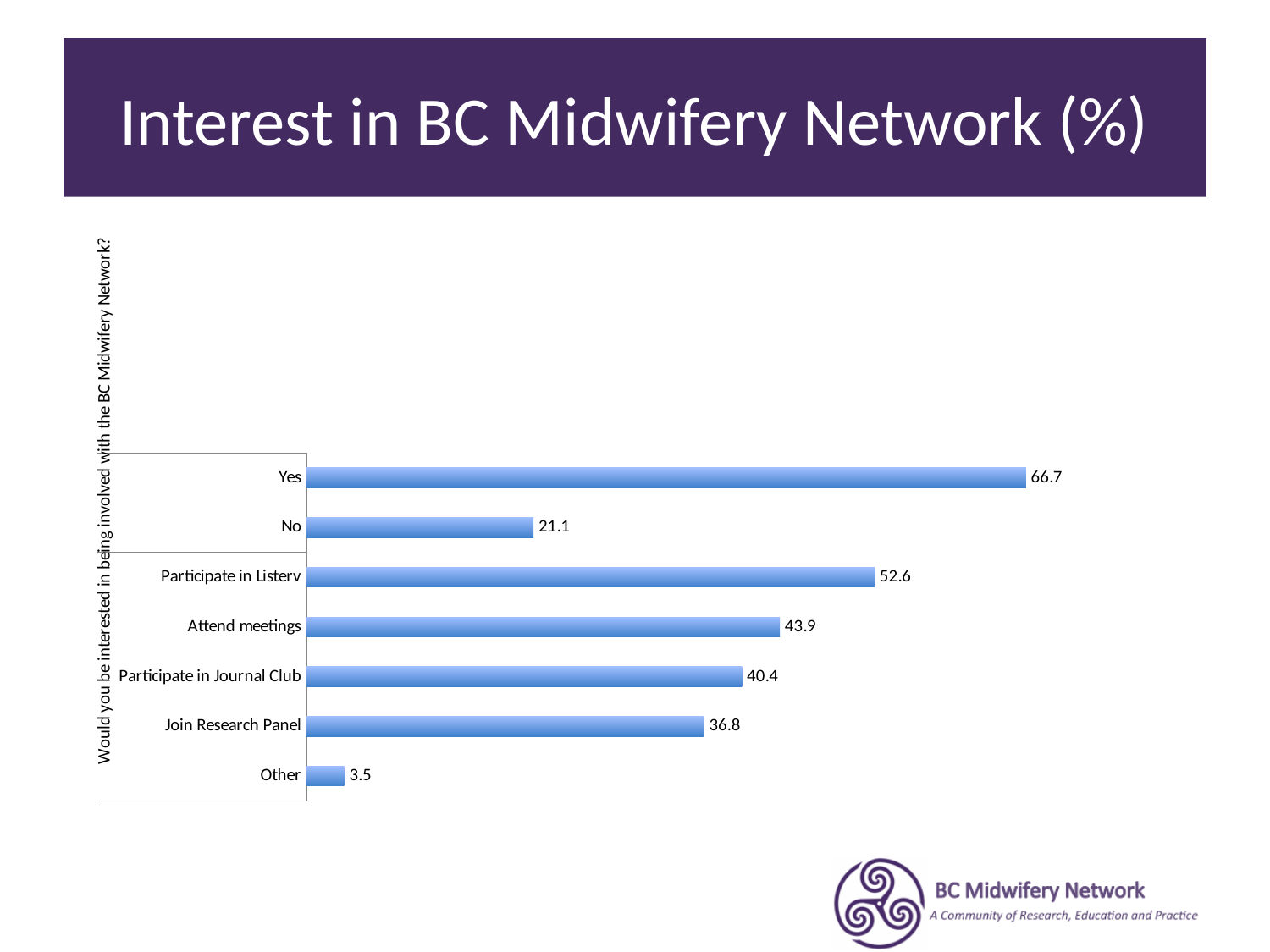
What is the difference between the values for Attend meetings and Participate in Journal Club? 3.5 How many categories are shown in the chart? 7 What is the value for Yes? 66.7 Which category has the highest value? Yes Which category has the lowest value? Other What is the difference between the values for Yes and No? 45.6 What is the title of the slide? Interest in BC Midwifery Network (%) What is the value for Participate in Listerv? 52.6 Which is larger, the value for Participate in Listerv or the value for Attend meetings? Participate in Listerv What is the label on the vertical axis of the chart? Would you be interested in being involved with the BC Midwifery Network? What kind of chart is shown on the slide? Bar chart What is the value for Join Research Panel? 36.8